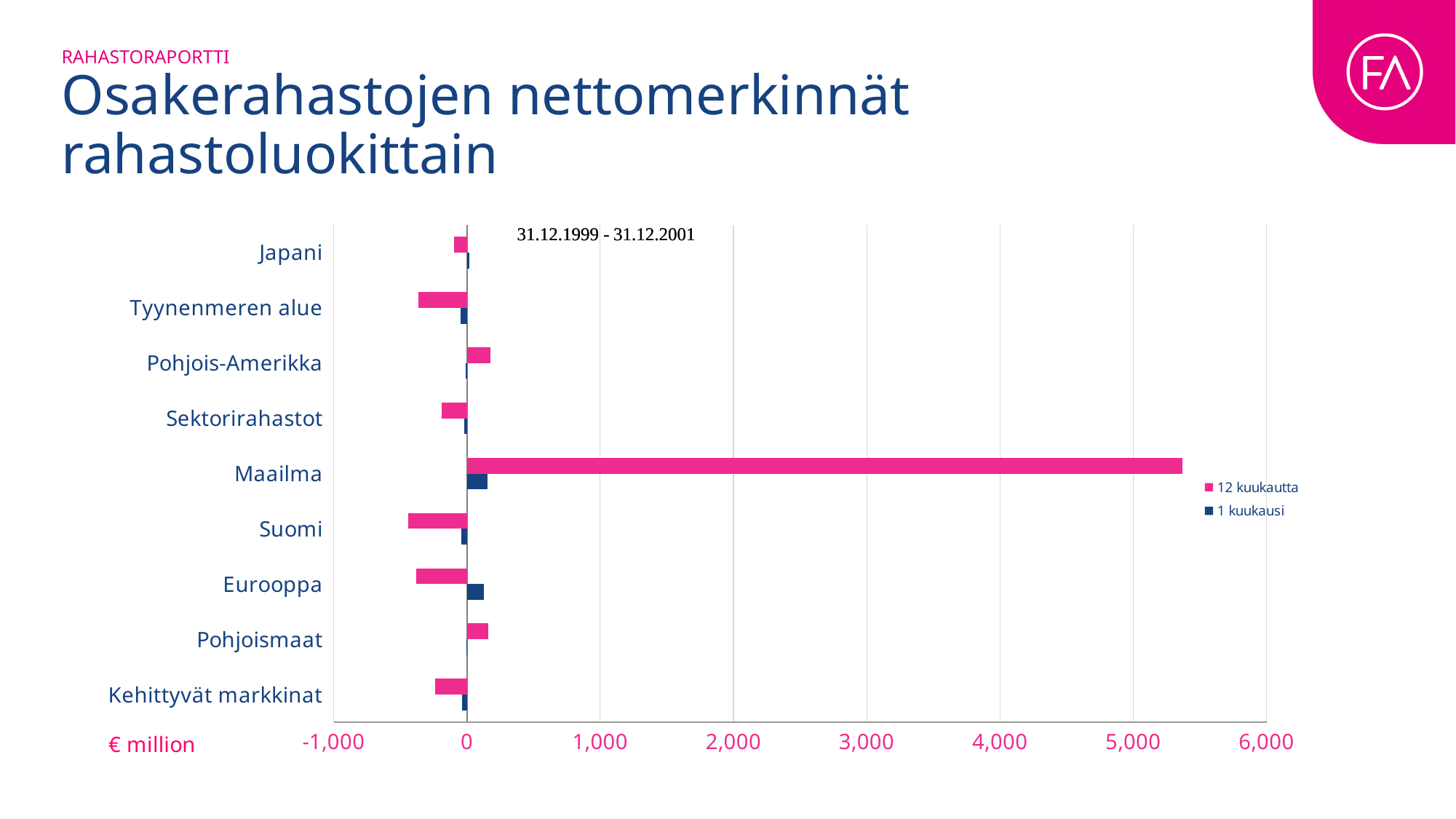
What period is shown in the label above the chart? 31.12.1999 - 31.12.2001 Is the 12 kuukautta value for Pohjois-Amerikka greater or less than 0? greater What unit is shown for the horizontal axis of the chart? € million Is the 12 kuukautta value for Suomi greater or less than 0? less Which category has the highest value for the 12 kuukautta series? Maailma Is the 12 kuukautta value for Maailma greater or less than 5,000? greater Which is larger for the 12 kuukautta series: Maailma or Suomi? Maailma What kind of chart is shown on the slide? bar chart How many fund categories are listed on the vertical axis of the chart? 9 Which is larger for the 12 kuukautta series: Pohjoismaat or Kehittyvät markkinat? Pohjoismaat How many series does the chart legend list? 2